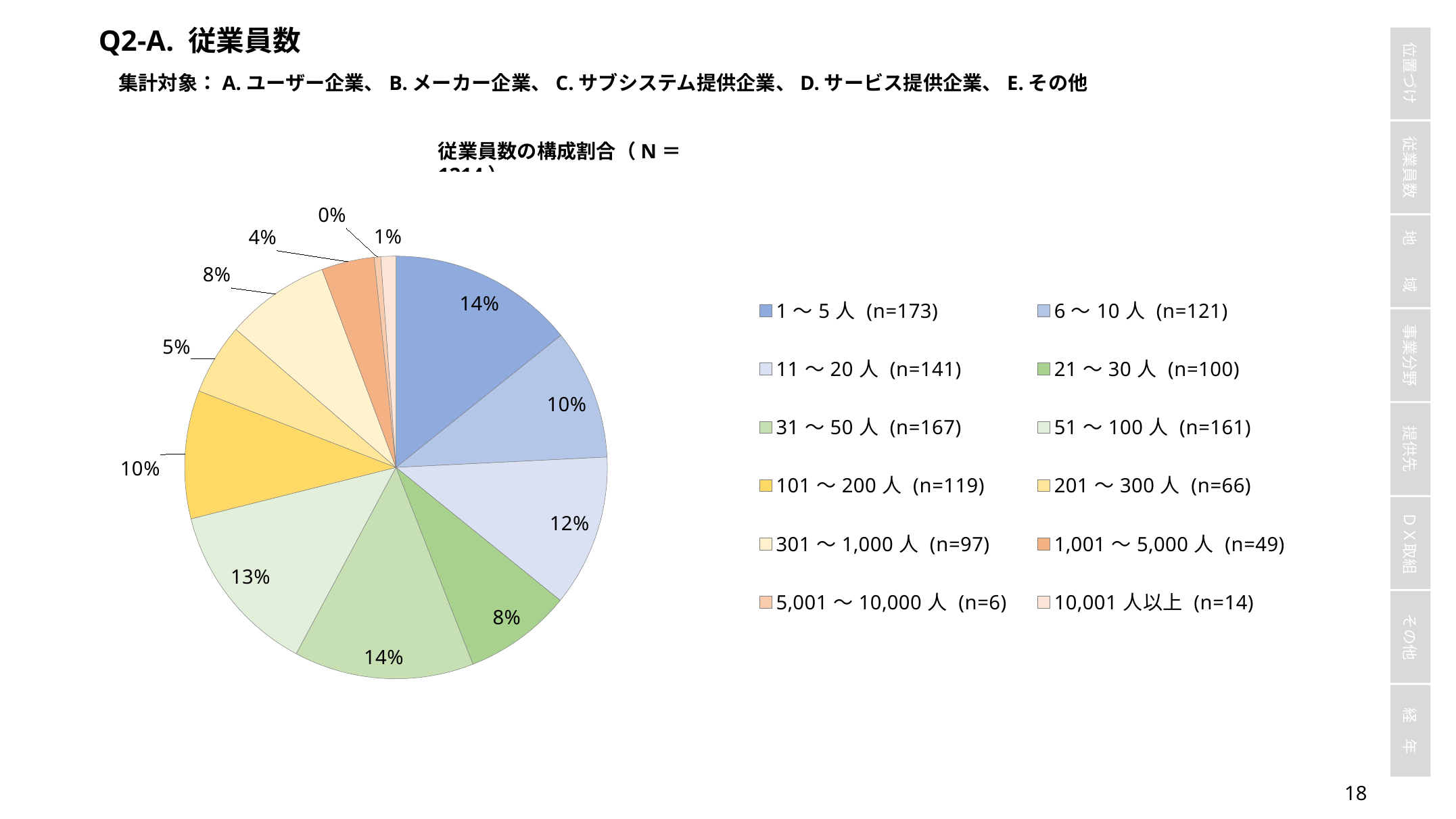
Which has the larger share of the pie, 11～20人 or 21～30人? 11～20人 According to the legend, what is the n value for the 11～20人 category? n=141 Which category has the smallest share of the pie? 5,001～10,000人 What is the difference in percentage points between the 51～100人 share and the 101～200人 share? 3 percentage points What share of the pie does the 1,001～5,000人 category hold? 4% What share of the pie does the 1～5人 category hold? 14% How many categories does the legend of the pie chart list? 12 What share of the pie does the 201～300人 category hold? 5% What kind of chart is shown on the slide? pie chart Which category has the largest n value in the legend? 1～5人 (n=173) According to the legend, what is the n value for the 10,001人以上 category? n=14